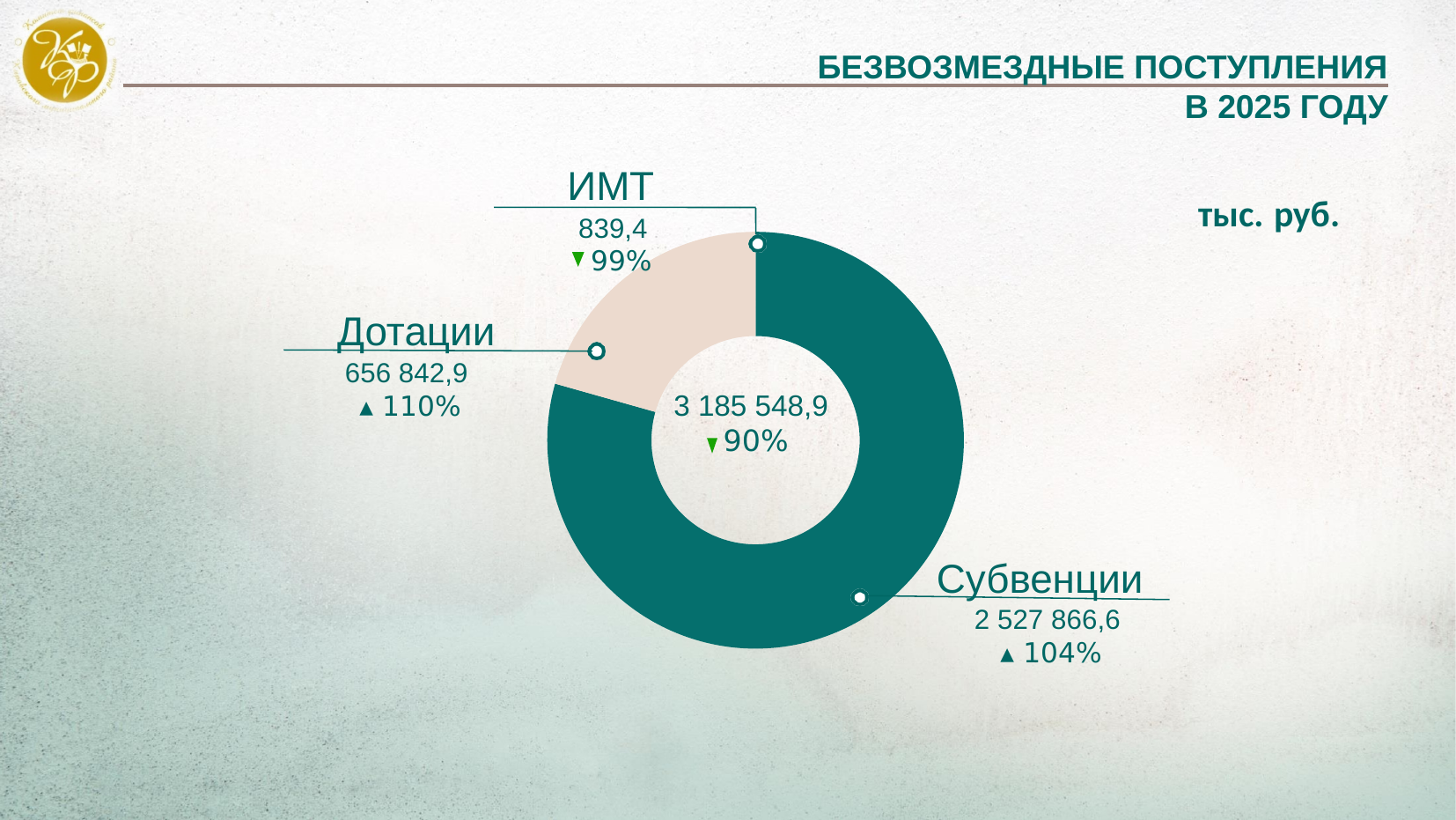
What is the difference between the values for Субвенции and Дотации? 1 871 023,7 What kind of chart is shown on the slide? Pie (donut) chart Which category has the lowest value? ИМТ What is the value for Дотации? 656 842,9 Which category has the highest value? Субвенции What unit of measurement is indicated on the slide? тыс. руб. What total value is shown in the centre of the chart? 3 185 548,9 How many categories are shown in the chart? 3 What is the value for ИМТ? 839,4 What is the value for Субвенции? 2 527 866,6 What percentage indicator is shown next to Дотации? ▲ 110% Which is larger, the value for Дотации or the value for ИМТ? Дотации